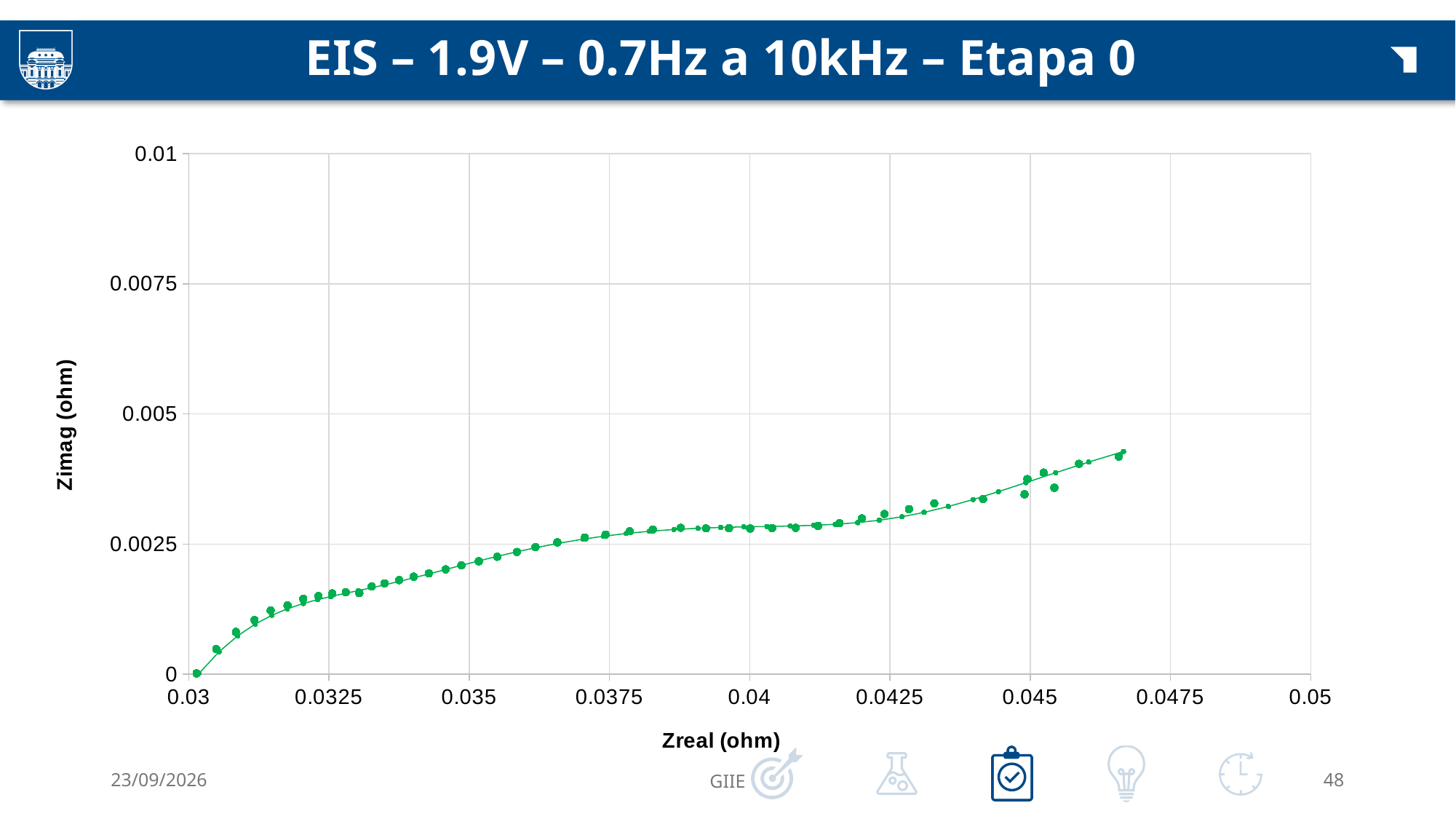
What is the maximum value shown on the vertical axis? 0.01 Is the largest Zreal value plotted greater or less than 0.0475? less Is the Zimag value at Zreal = 0.035 greater or less than 0.0025? less What kind of chart is shown on the slide? scatter plot with a fitted line What is the title of the chart on the slide? EIS – 1.9V – 0.7Hz a 10kHz – Etapa 0 Is the Zimag value at Zreal = 0.045 greater or less than 0.0025? greater Which has the larger Zimag value: the point at Zreal = 0.0325 or the point at Zreal = 0.0425? the point at Zreal = 0.0425 Do the Zimag values generally rise or fall as Zreal increases along the x axis? rise What is the label of the horizontal axis? Zreal (ohm)